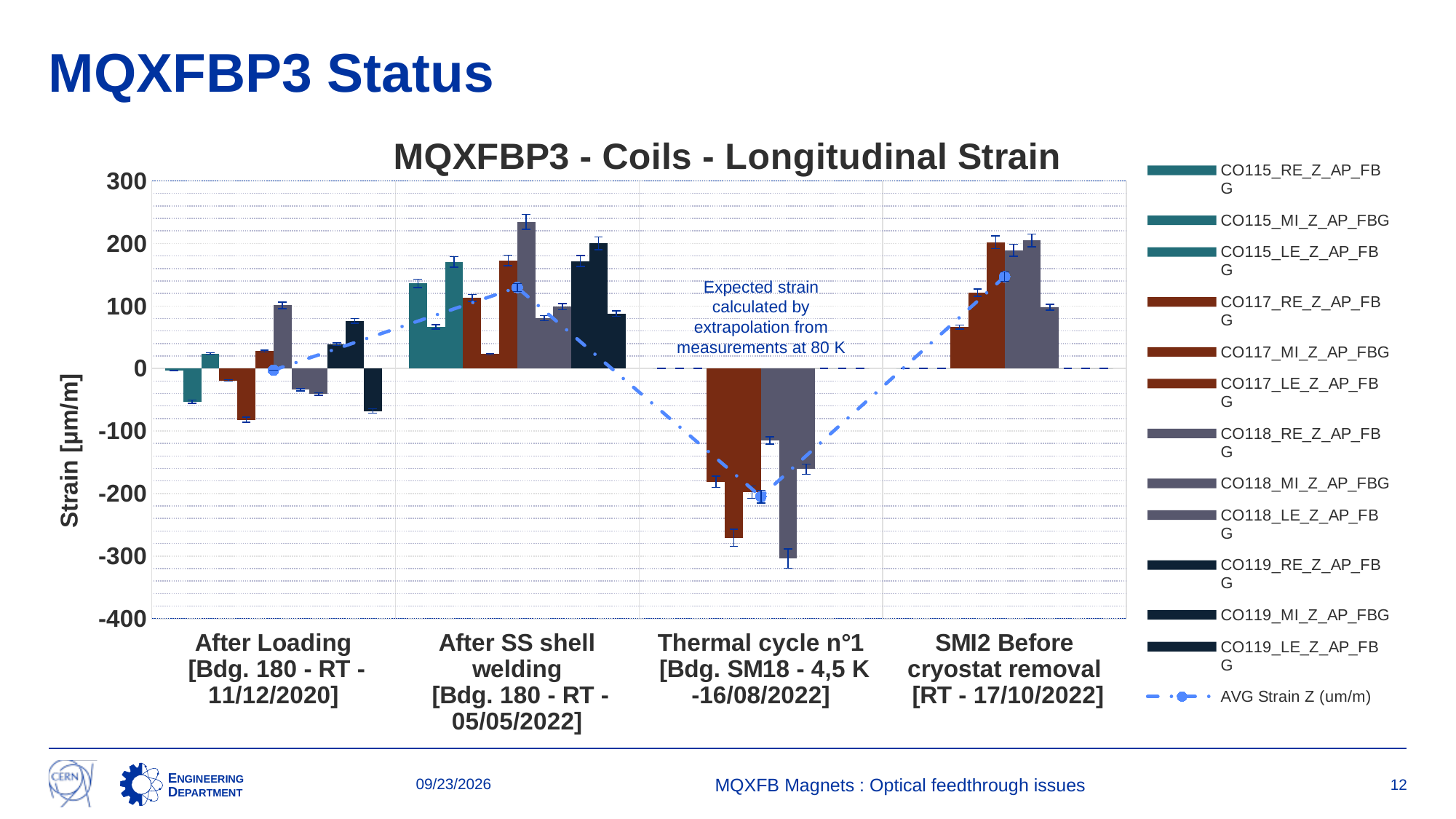
How many series does the chart's legend list? 13 Which series has the lowest value in the Thermal cycle n°1 category? CO118_MI_Z_AP_FBG What kind of chart is shown on the slide? Combination bar and line chart Is the value for CO118_RE_Z_AP_FBG in the After SS shell welding category greater or less than 200? greater Is the value for CO117_MI_Z_AP_FBG in the Thermal cycle n°1 category greater or less than -200? less In the Thermal cycle n°1 category, which is larger: the value for CO117_RE_Z_AP_FBG or CO118_RE_Z_AP_FBG? CO118_RE_Z_AP_FBG How many categories are shown along the x axis of the chart? 4 What is the title of the chart? MQXFBP3 - Coils - Longitudinal Strain What is the label of the y axis of the chart? Strain [µm/m] Is the value for CO117_MI_Z_AP_FBG in the After Loading category greater or less than 0? less In which category is the AVG Strain Z value lowest? Thermal cycle n°1 [Bdg. SM18 - 4,5 K -16/08/2022]